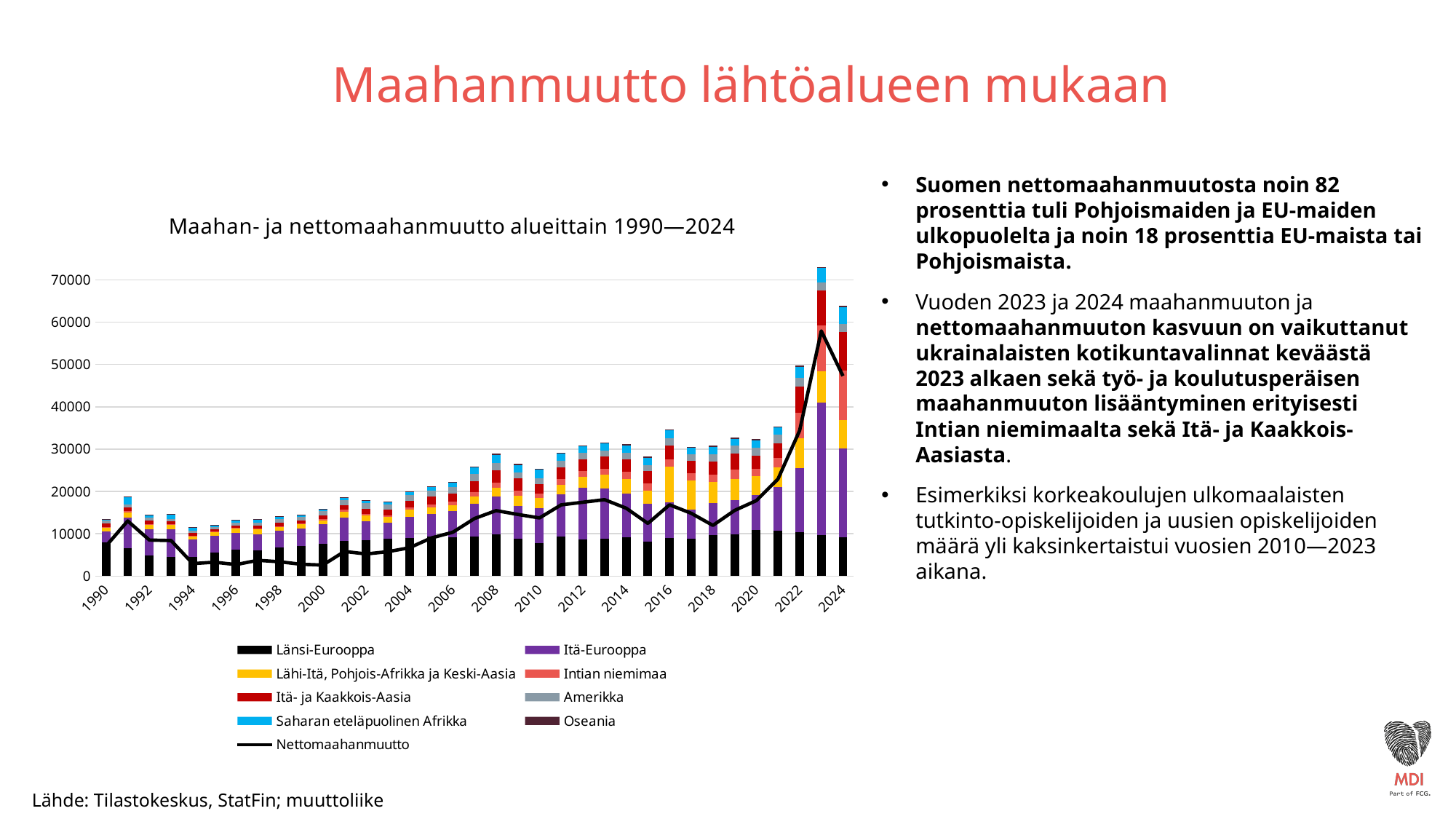
What is the title of the chart? Maahan- ja nettomaahanmuutto alueittain 1990—2024 Which year has the tallest stacked bar? 2023 Is the Nettomaahanmuutto line value for 2023 greater or less than 50000? greater Is the total stacked bar for 2024 greater or less than 60000? greater Does the total immigration (stacked bar height) generally rise or fall from 1990 to 2024? rise Which year has the taller stacked bar, 1990 or 1991? 1991 Is the total stacked bar for 2023 greater or less than 70000? greater What kind of chart is shown on the slide? Stacked bar chart with a line How many entries does the chart legend list? 9 Which series is shown in black bars in the chart? Länsi-Eurooppa How many years (bars) are plotted in the chart? 35